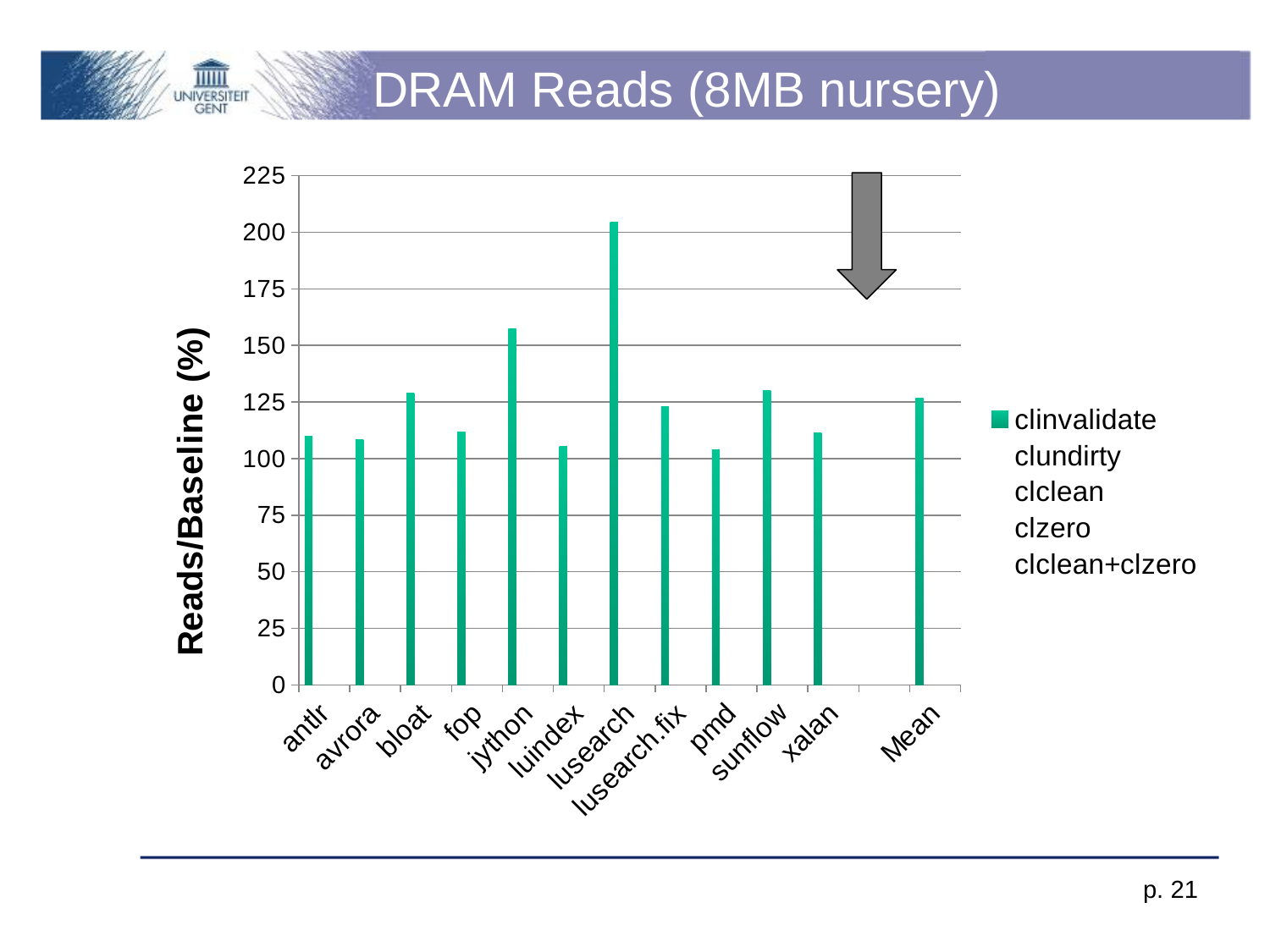
Which category has the highest value in the chart? lusearch Is the value for Mean greater or less than 150? less Which has a larger value, lusearch or sunflow? lusearch Is the value for lusearch greater or less than 200? greater How many categories are shown along the x axis of the chart? 12 What is the title of the chart on the slide? DRAM Reads (8MB nursery) How many entries does the legend list? 5 What kind of chart is shown on the slide? bar chart Which has a larger value, jython or bloat? jython Is the value for pmd greater or less than 125? less What is the label of the y axis? Reads/Baseline (%)